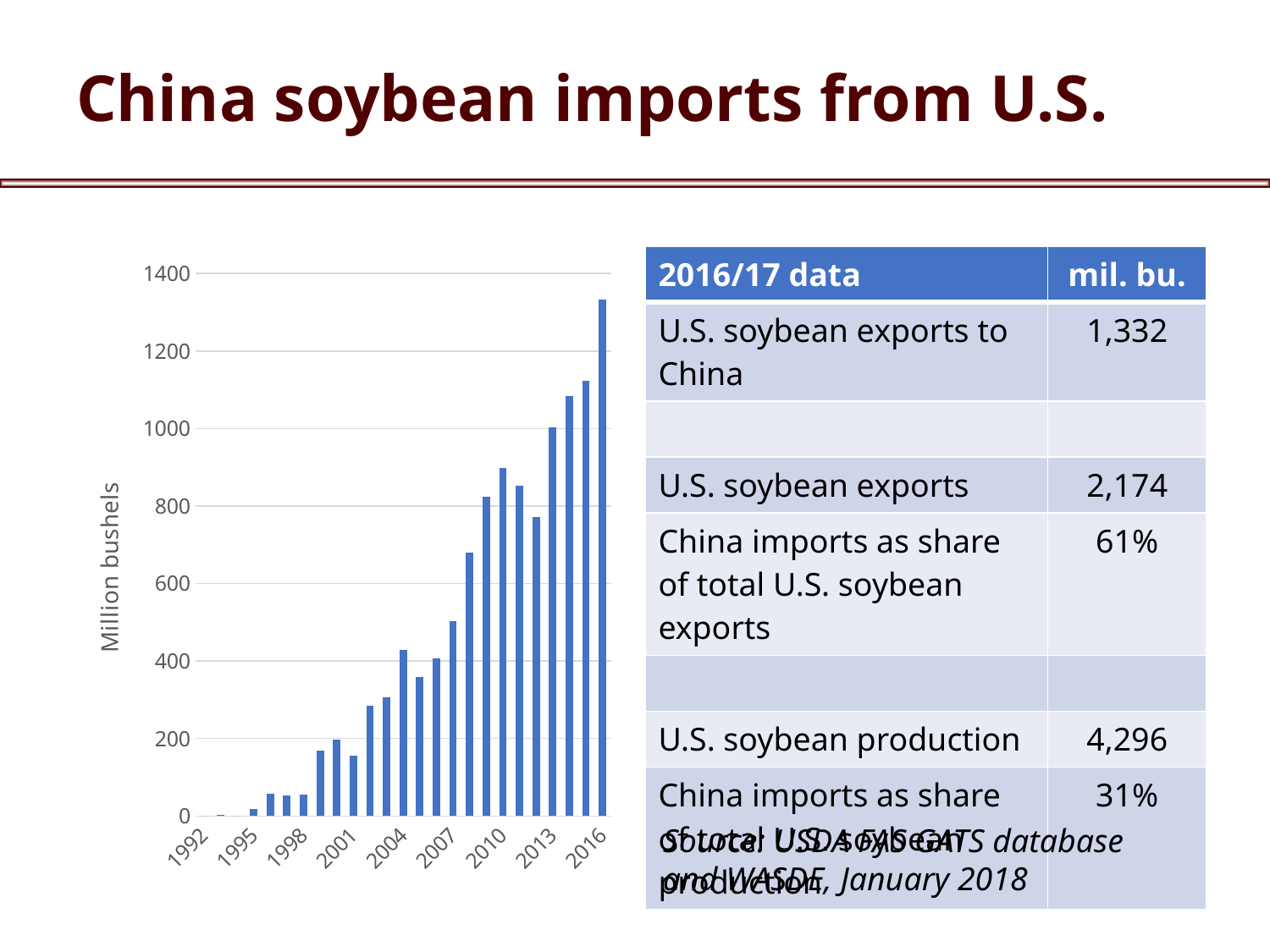
Which year has the tallest bar in the chart? 2016 Which is larger, the value for 1995 or the value for 2013? 2013 Is the value for 2013 greater or less than 800? greater What kind of chart is shown on the slide? Bar chart Is the value for 2016 greater or less than 1200? greater Is the value for 2004 greater or less than 600? less Overall, do the values in the chart rise or fall from 1992 to 2016? Rise What is the label on the vertical axis of the chart? Million bushels What is the title of the slide's chart? China soybean imports from U.S. Which is larger, the value for 2016 or the value for 2010? 2016